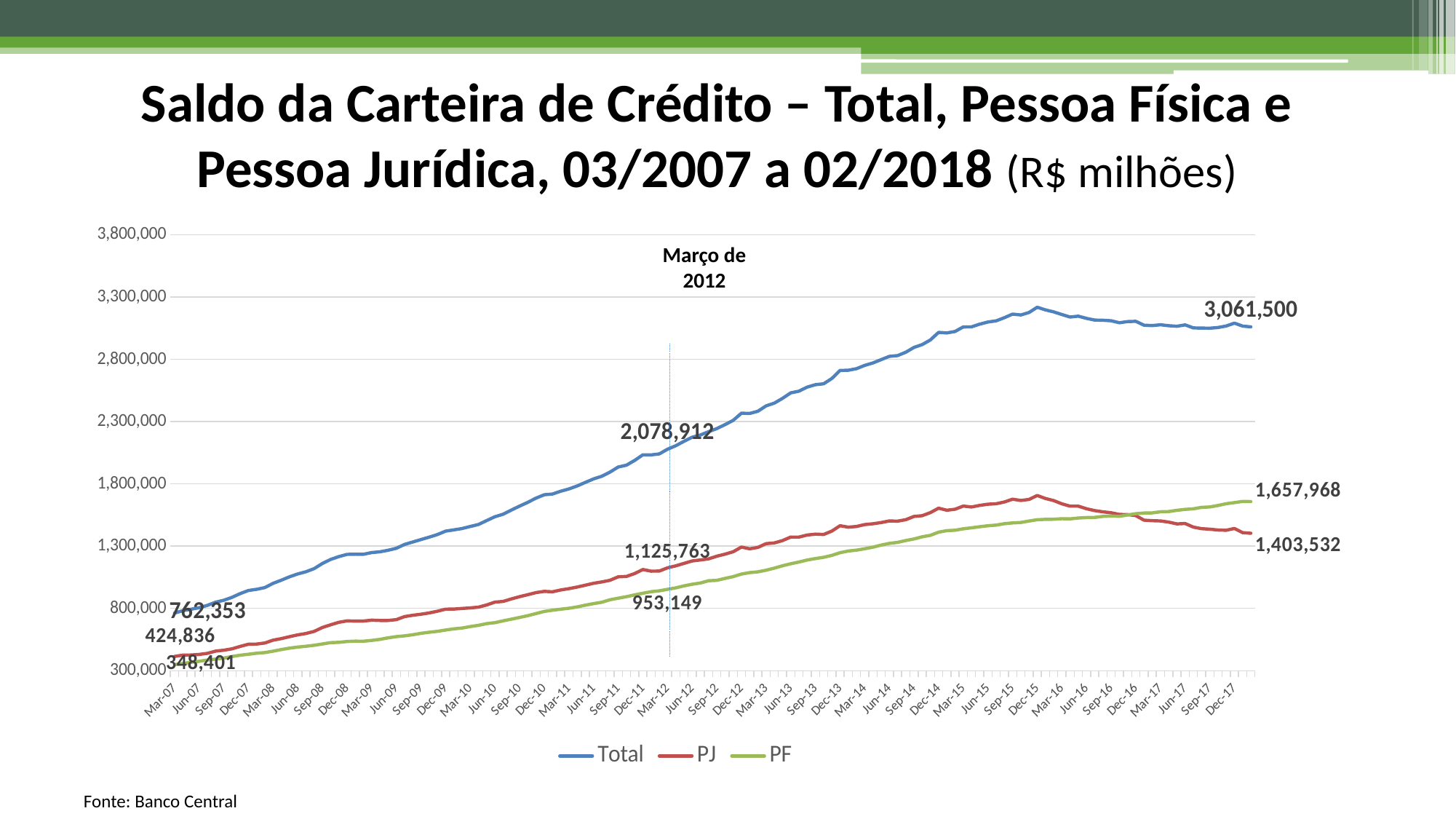
What is the value of the PF series at the end of the chart? 1,657,968 What is the value of the Total series at the start of the chart (Mar-07)? 762,353 What kind of chart is shown on the slide? line chart At the end of the chart, which series has the higher value, PF or PJ? PF What is the value of the PF series at the start of the chart (Mar-07)? 348,401 Does the PF series rise or fall over the period shown? rise What is the value of the PJ series at the end of the chart? 1,403,532 How many series does the legend list? 3 What is the value of the PJ series in March 2012 (Março de 2012)? 1,125,763 What is the value of the Total series in March 2012 (Março de 2012)? 2,078,912 What is the difference between the Total value at the end of the chart (3,061,500) and the Total value in March 2012 (2,078,912)? 982,588